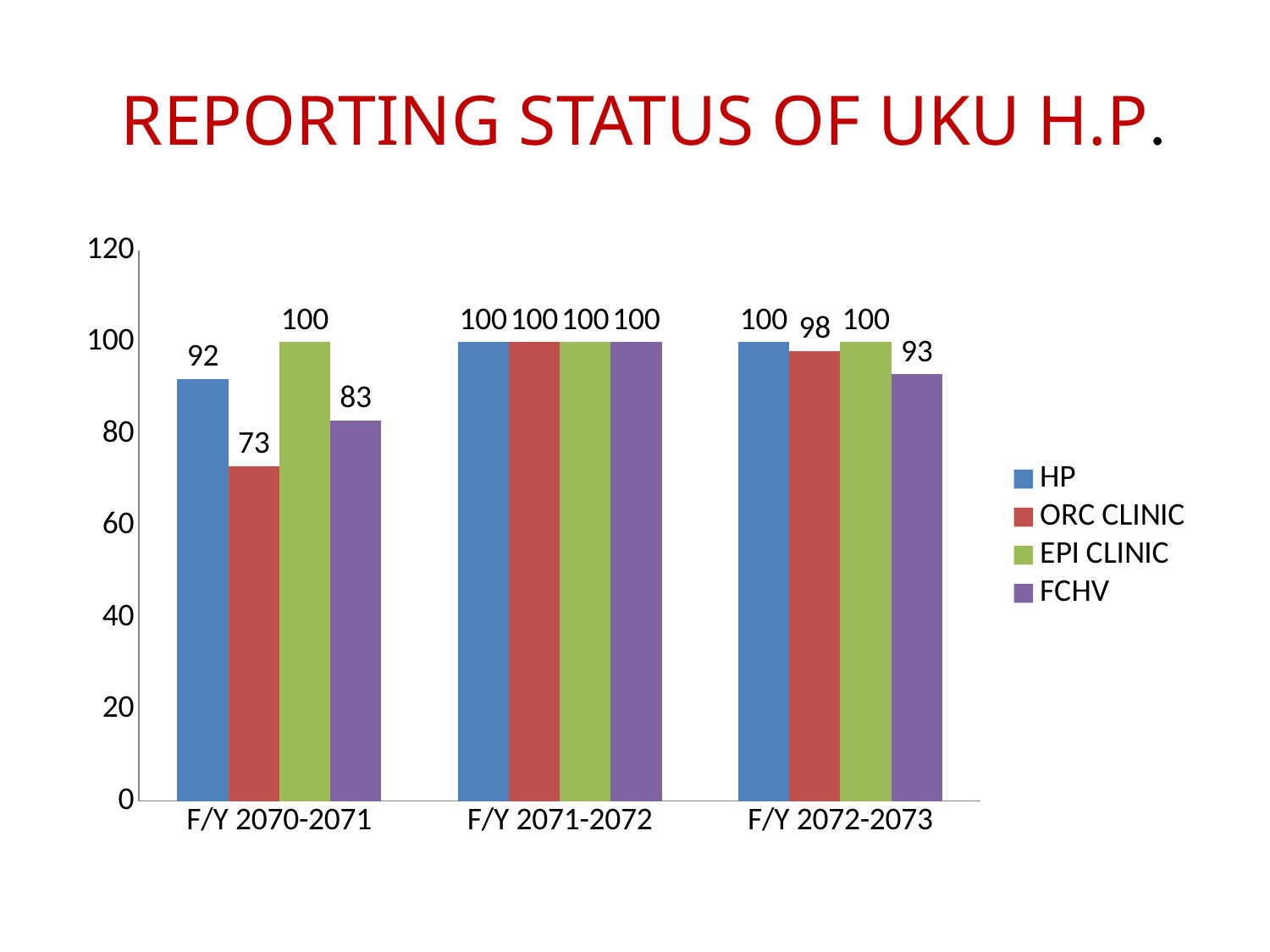
Which series has the lowest value in F/Y 2072-2073? FCHV How many series does the legend list? 4 What is the value for ORC CLINIC in F/Y 2072-2073? 98 What is the title of the chart? REPORTING STATUS OF UKU H.P. Which series has the lowest value in F/Y 2070-2071? ORC CLINIC What is the difference between the EPI CLINIC and ORC CLINIC values in F/Y 2070-2071? 27 How many fiscal year categories are shown on the x axis? 3 What is the value for ORC CLINIC in F/Y 2070-2071? 73 What is the value for FCHV in F/Y 2072-2073? 93 What kind of chart is shown on the slide? Bar chart What is the value for HP in F/Y 2070-2071? 92 Which is larger in F/Y 2070-2071, the HP value or the FCHV value? HP